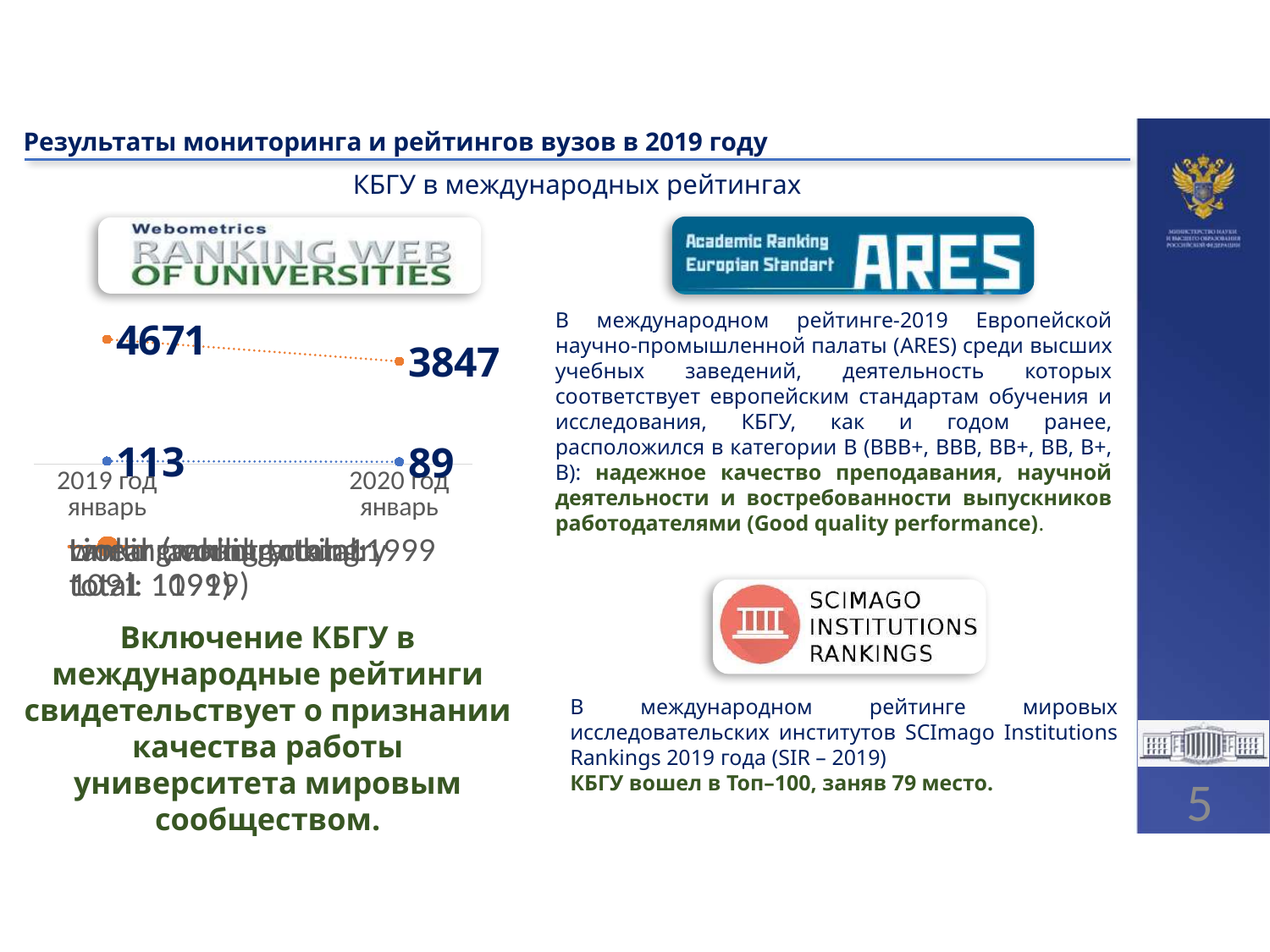
What is the value of the orange line for 2019 год январь? 4671 What is the difference between the blue line's values for 2019 год январь and 2020 год январь? 24 What is the value of the blue line for 2019 год январь? 113 How many lines are plotted on the chart? 2 What is the value of the orange line for 2020 год январь? 3847 Does the orange line rise or fall from 2019 год январь to 2020 год январь? fall What is the value of the blue line for 2020 год январь? 89 Which year has the higher value on the orange line, 2019 год январь or 2020 год январь? 2019 год январь By how much did the orange line's value change from 2019 год январь to 2020 год январь? 824 What type of chart is shown on the slide? line chart Does the blue line rise or fall from 2019 год январь to 2020 год январь? fall How many categories are shown on the x axis of the chart? 2